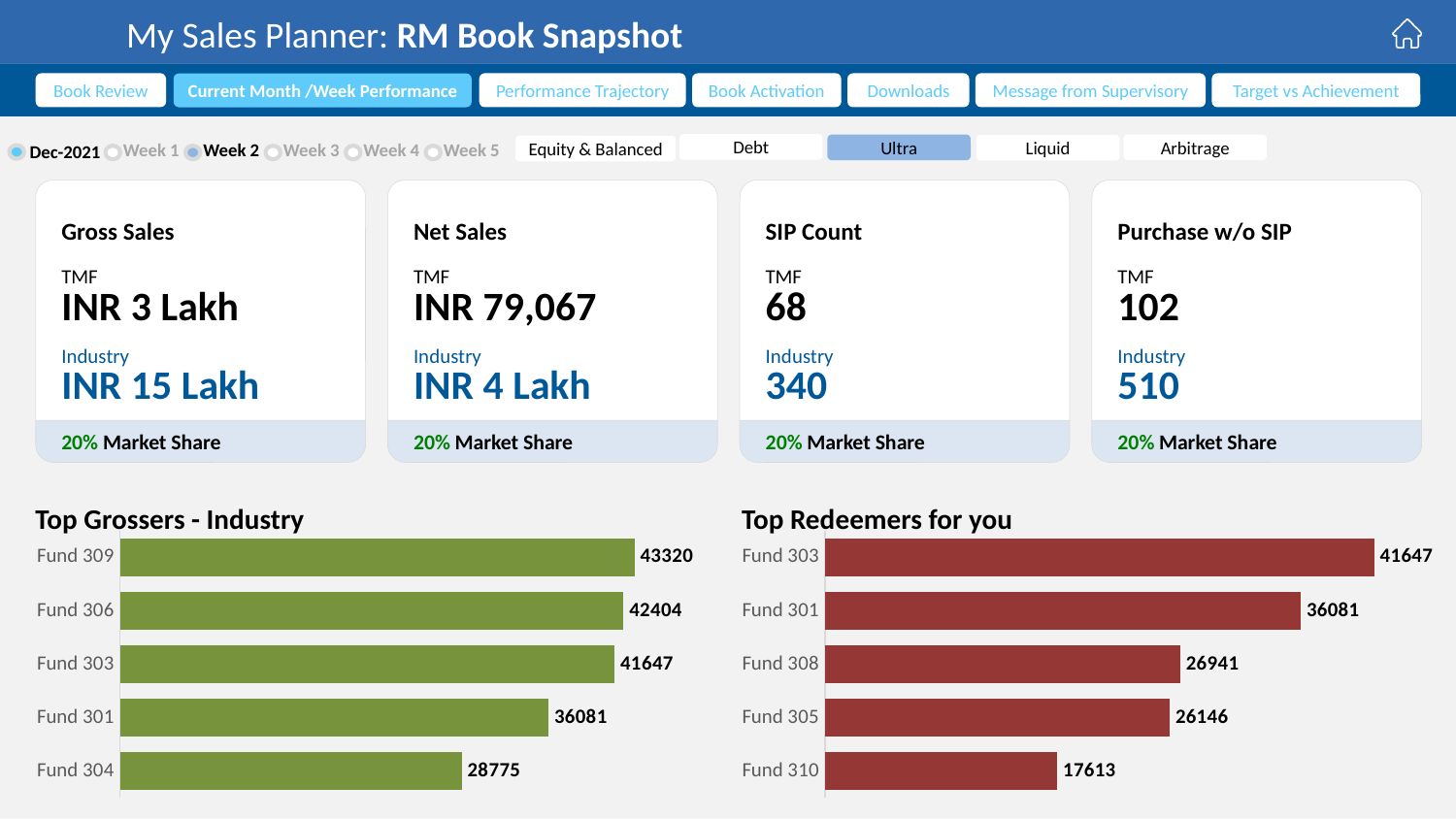
How many funds are shown in the 'Top Grossers - Industry' chart? 5 In the 'Top Grossers - Industry' chart, what is the difference between the values for Fund 309 and Fund 304? 14545 In the 'Top Redeemers for you' chart, which fund has the lowest value? Fund 310 In the 'Top Grossers - Industry' chart, which fund has the highest value? Fund 309 In the 'Top Redeemers for you' chart, what is the value for Fund 308? 26941 How many funds are shown in the 'Top Redeemers for you' chart? 5 What colour are the bars in the 'Top Grossers - Industry' chart? Green In the 'Top Grossers - Industry' chart, what is the value for Fund 301? 36081 In the 'Top Grossers - Industry' chart, what is the value for Fund 306? 42404 In the 'Top Redeemers for you' chart, what is the difference between the values for Fund 303 and Fund 301? 5566 In the 'Top Redeemers for you' chart, which is larger: the value for Fund 308 or Fund 305? Fund 308 What type of chart is 'Top Redeemers for you'? Bar chart